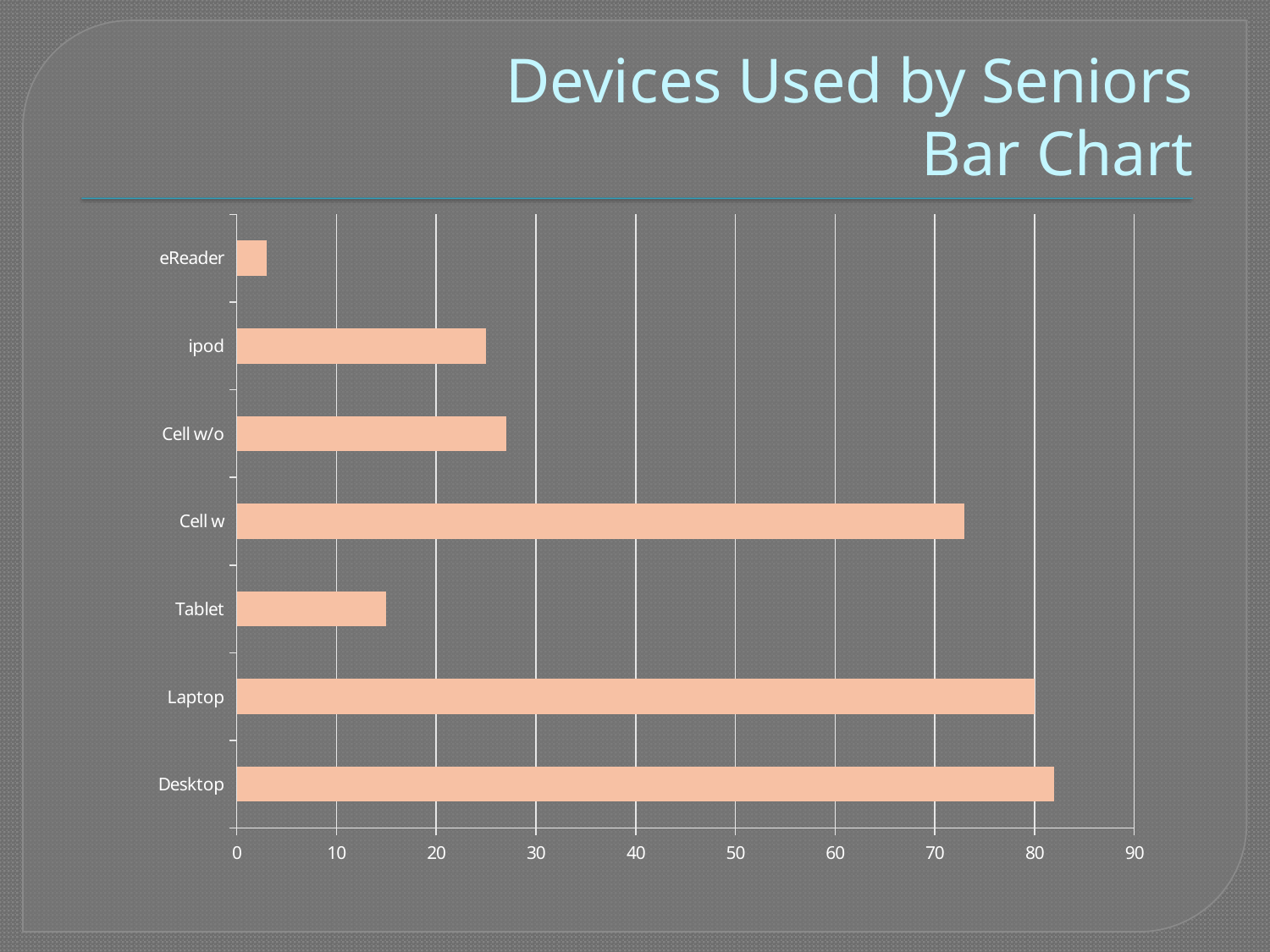
Which has a larger value, Tablet or ipod? ipod How many device categories are shown in the chart? 7 What kind of chart is shown on the slide? Bar chart What is the title of the slide? Devices Used by Seniors Bar Chart Is the value for Cell w/o greater or less than 30? less Which has a larger value, Cell w or Cell w/o? Cell w Which device category has the lowest value? eReader Is the value for Cell w greater or less than 70? greater Is the value for eReader greater or less than 10? less What is the value for Laptop? 80 Which device category has the highest value? Desktop